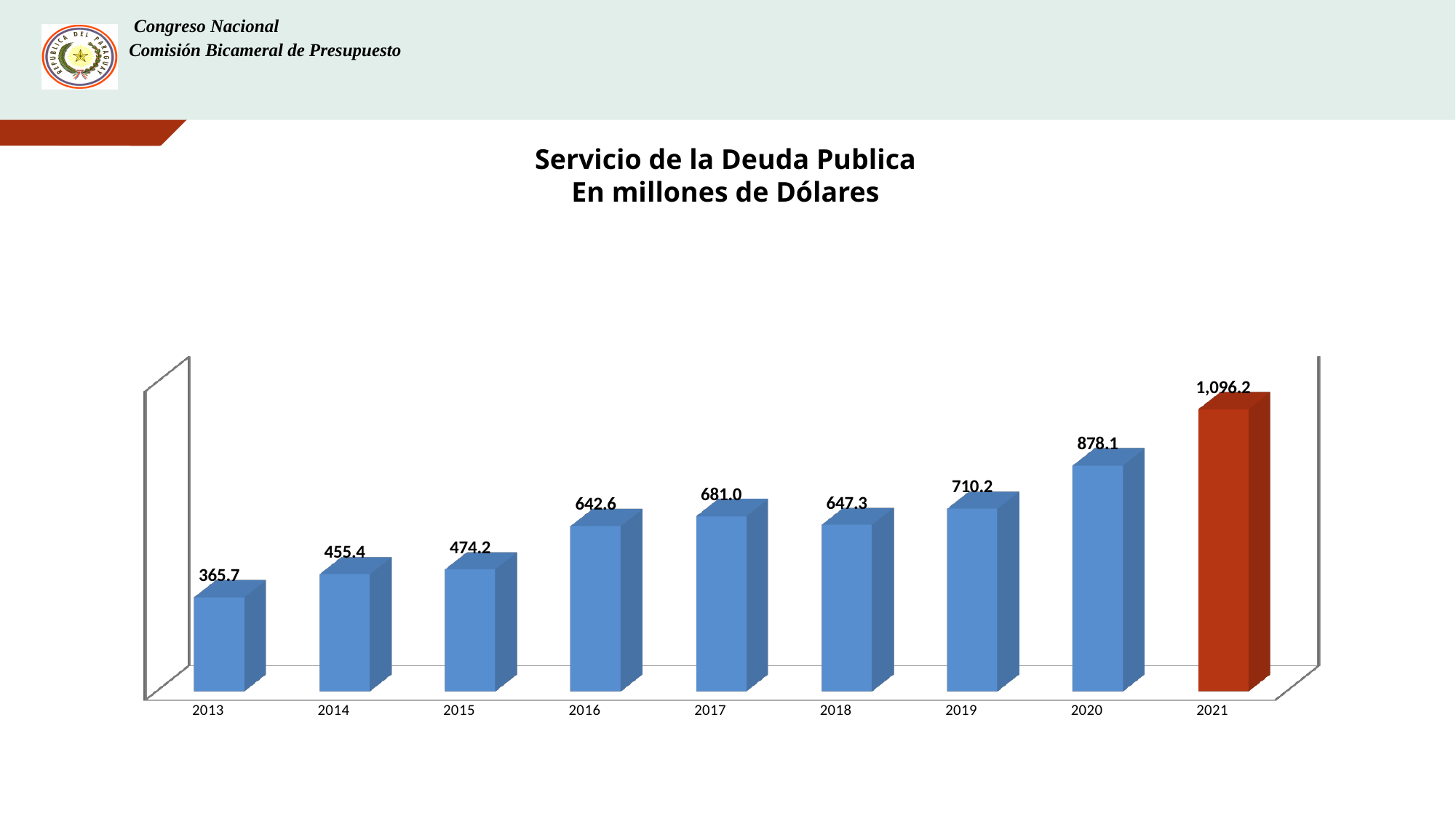
Which year has the lowest value? 2013 What is the value for 2013? 365.7 What is the difference between the values for 2017 and 2018? 33.7 Which year has the highest value? 2021 How many years are shown on the x axis? 9 Do the values generally rise or fall from 2013 to 2021? rise Which is larger, the value for 2016 or the value for 2018? 2018 What is the value for 2017? 681.0 Which bar is shown in a different colour from the others? 2021 What kind of chart is this? bar chart What is the difference between the values for 2021 and 2020? 218.1 What is the value for 2021? 1,096.2